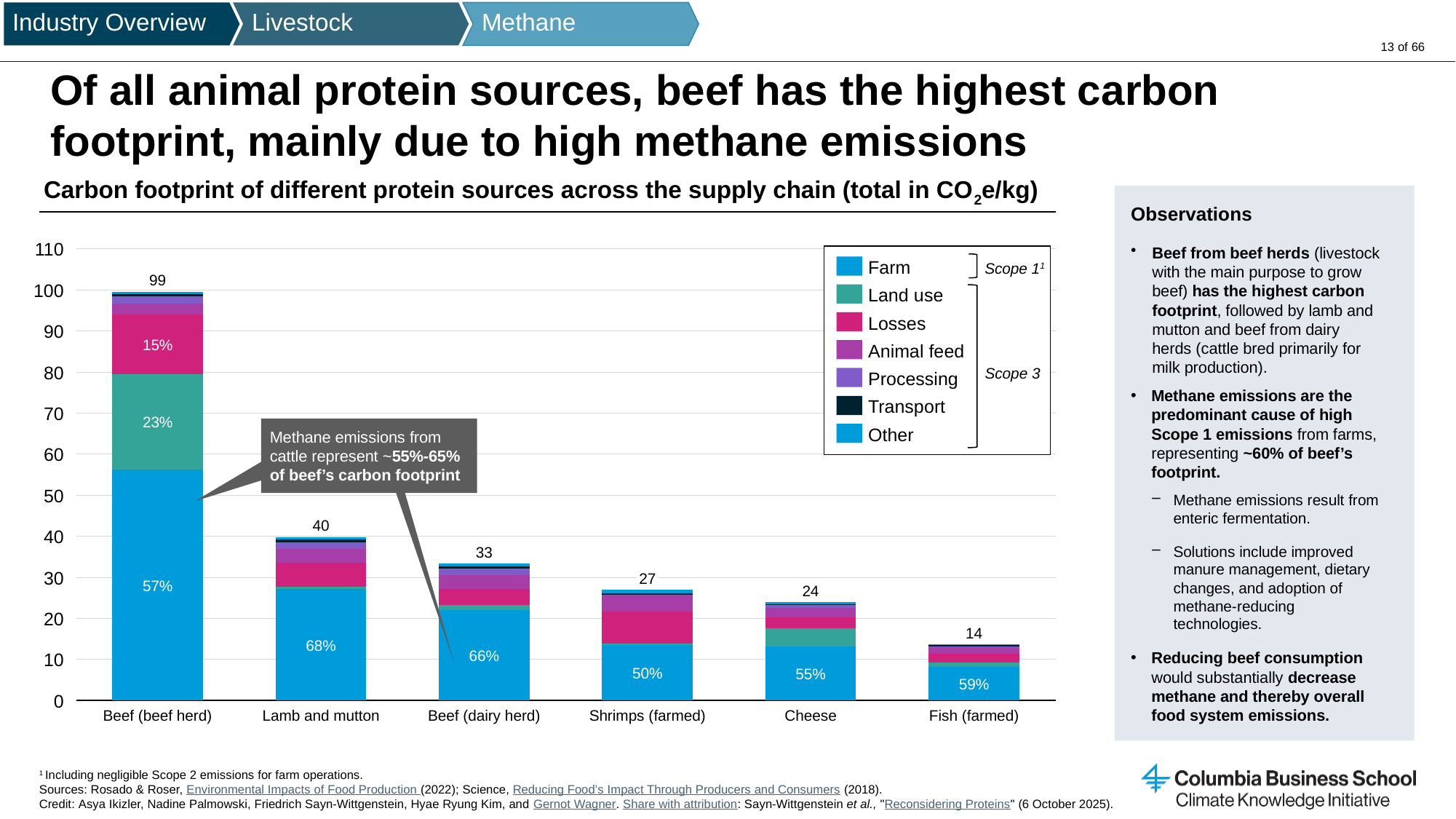
What kind of chart is shown on the slide? Stacked bar chart What percentage of the Beef (beef herd) bar is attributed to Land use? 23% What percentage of the Beef (dairy herd) bar is attributed to Farm? 66% Which has a larger total carbon footprint, Shrimps (farmed) or Cheese? Shrimps (farmed) What is the difference between the total carbon footprint of Beef (beef herd) and Lamb and mutton? 59 How many series does the legend list? 7 Which legend entry is labelled as Scope 1? Farm Which protein source has the lowest total carbon footprint? Fish (farmed) How many protein sources are shown on the x axis? 6 What is the total carbon footprint shown for Lamb and mutton? 40 What is the total carbon footprint shown for Beef (beef herd)? 99 Which protein source has the highest total carbon footprint? Beef (beef herd)